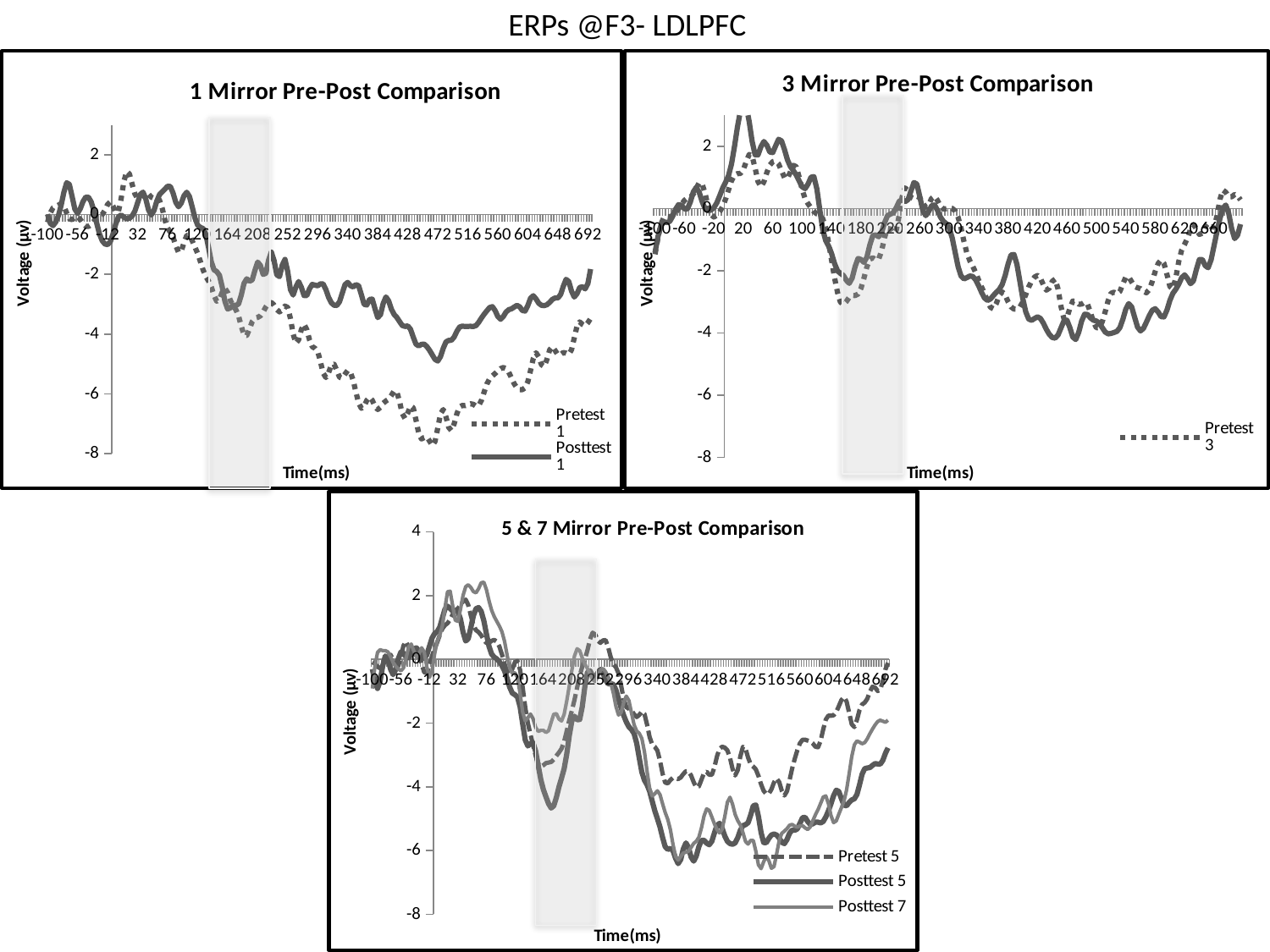
How many series does the legend of the "1 Mirror Pre-Post Comparison" chart list? 2 What kind of chart is the "1 Mirror Pre-Post Comparison" chart? Line chart In the "1 Mirror Pre-Post Comparison" chart, which series reaches the lowest voltage, Pretest 1 or Posttest 1? Pretest 1 How many series does the legend of the "3 Mirror Pre-Post Comparison" chart list? 1 In the "5 & 7 Mirror Pre-Post Comparison" chart, is the value of Posttest 5 at 384 ms greater or less than -4? less How many series does the legend of the "5 & 7 Mirror Pre-Post Comparison" chart list? 3 What is the label of the vertical axis on the "5 & 7 Mirror Pre-Post Comparison" chart? Voltage (µv) In the "1 Mirror Pre-Post Comparison" chart, is the value of Posttest 1 at 472 ms greater or less than -6? greater In the "1 Mirror Pre-Post Comparison" chart, does the Posttest 1 line rise or fall between 252 ms and 472 ms? Fall What are the legend entries of the "5 & 7 Mirror Pre-Post Comparison" chart? Pretest 5, Posttest 5, Posttest 7 In the "1 Mirror Pre-Post Comparison" chart, is the value of Pretest 1 at 472 ms greater or less than -6? less